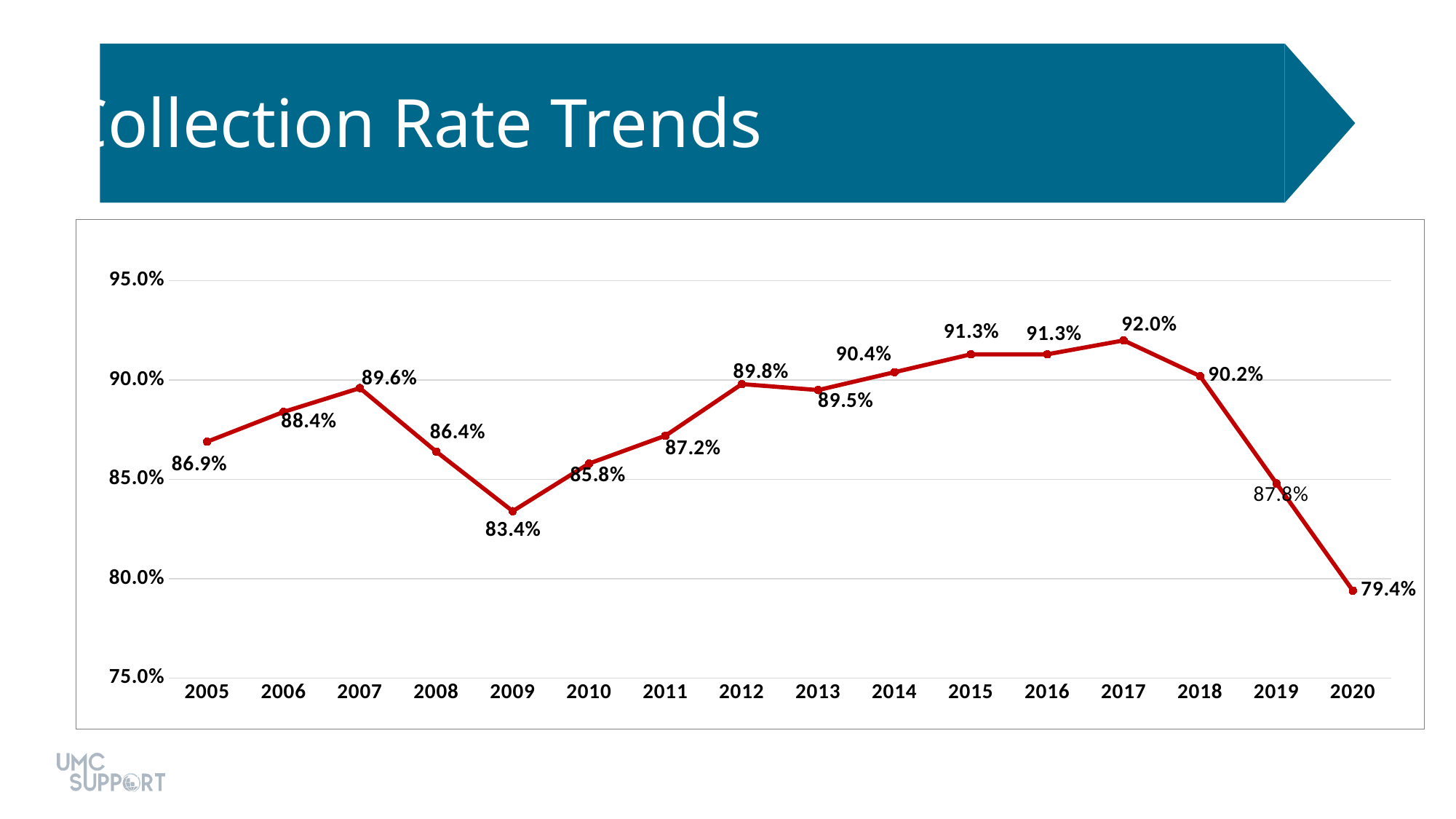
What is the collection rate for 2009? 83.4% What is the difference between the collection rates for 2017 and 2020? 12.6% What is the difference between the collection rates for 2007 and 2008? 3.2% What is the collection rate for 2020? 79.4% Which is larger, the collection rate for 2005 or for 2006? 2006 What is the collection rate for 2017? 92.0% How many years are plotted on the x axis? 16 What is the collection rate for 2012? 89.8% Which year has the highest collection rate? 2017 Which year has the lowest collection rate? 2020 Is the collection rate for 2009 greater or less than 85.0%? less What kind of chart is shown on the slide? line chart